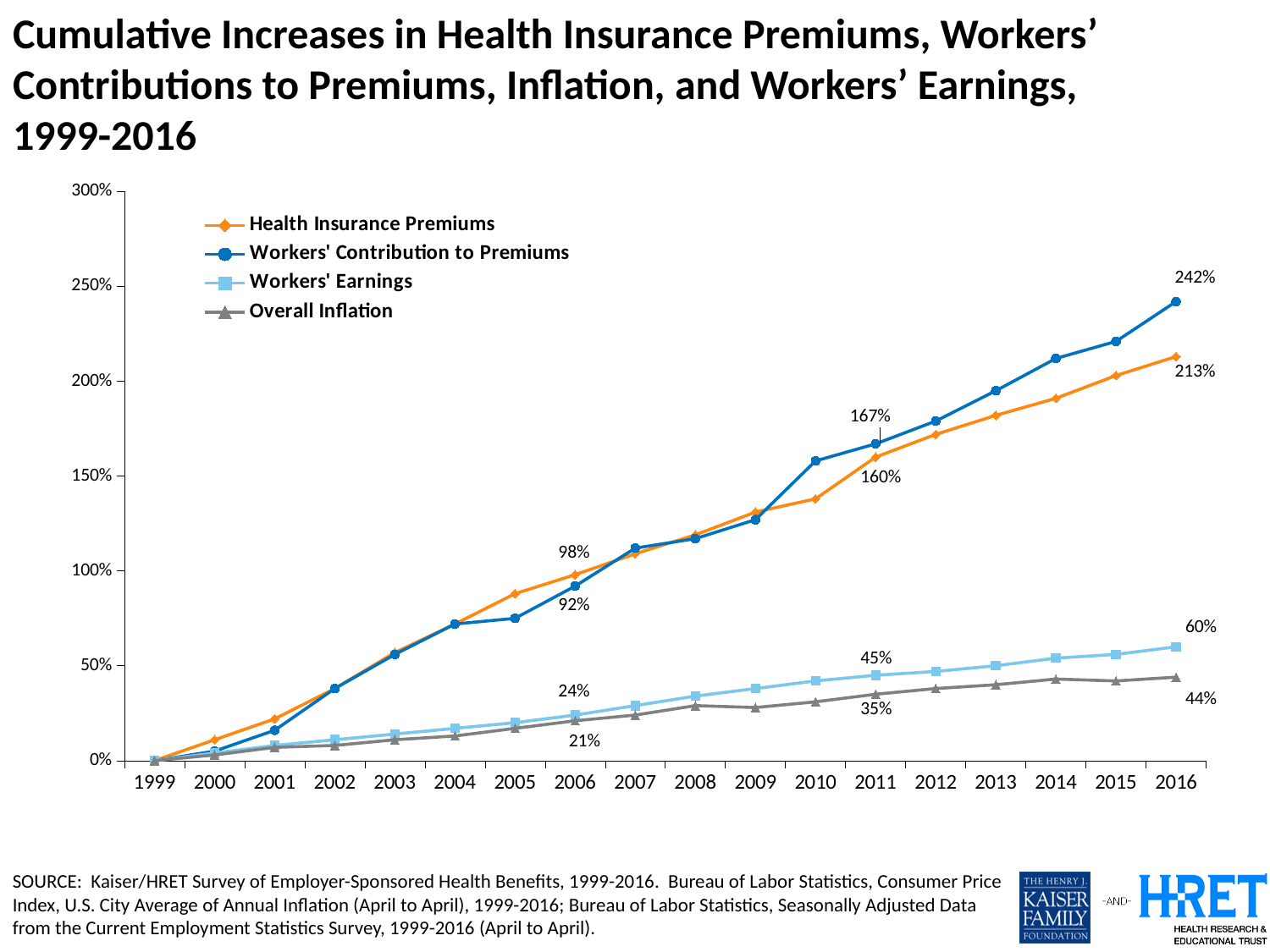
Which series has the highest value in 2016? Workers' Contribution to Premiums What kind of chart is shown on the slide? Line chart What is the cumulative increase in Workers' Contribution to Premiums in 2011? 167% In 2016, how many percentage points higher is Workers' Contribution to Premiums than Health Insurance Premiums? 29 percentage points Is the value for Health Insurance Premiums in 2010 greater or less than 150%? less In 2011, which is larger: Workers' Earnings or Overall Inflation? Workers' Earnings What is the cumulative increase in Workers' Contribution to Premiums in 2016? 242% How many years are plotted along the x axis? 18 What is the cumulative increase in Health Insurance Premiums in 2016? 213% How many series does the legend list? 4 What is the cumulative increase in Workers' Earnings in 2016? 60% What is the cumulative increase in Overall Inflation in 2016? 44%